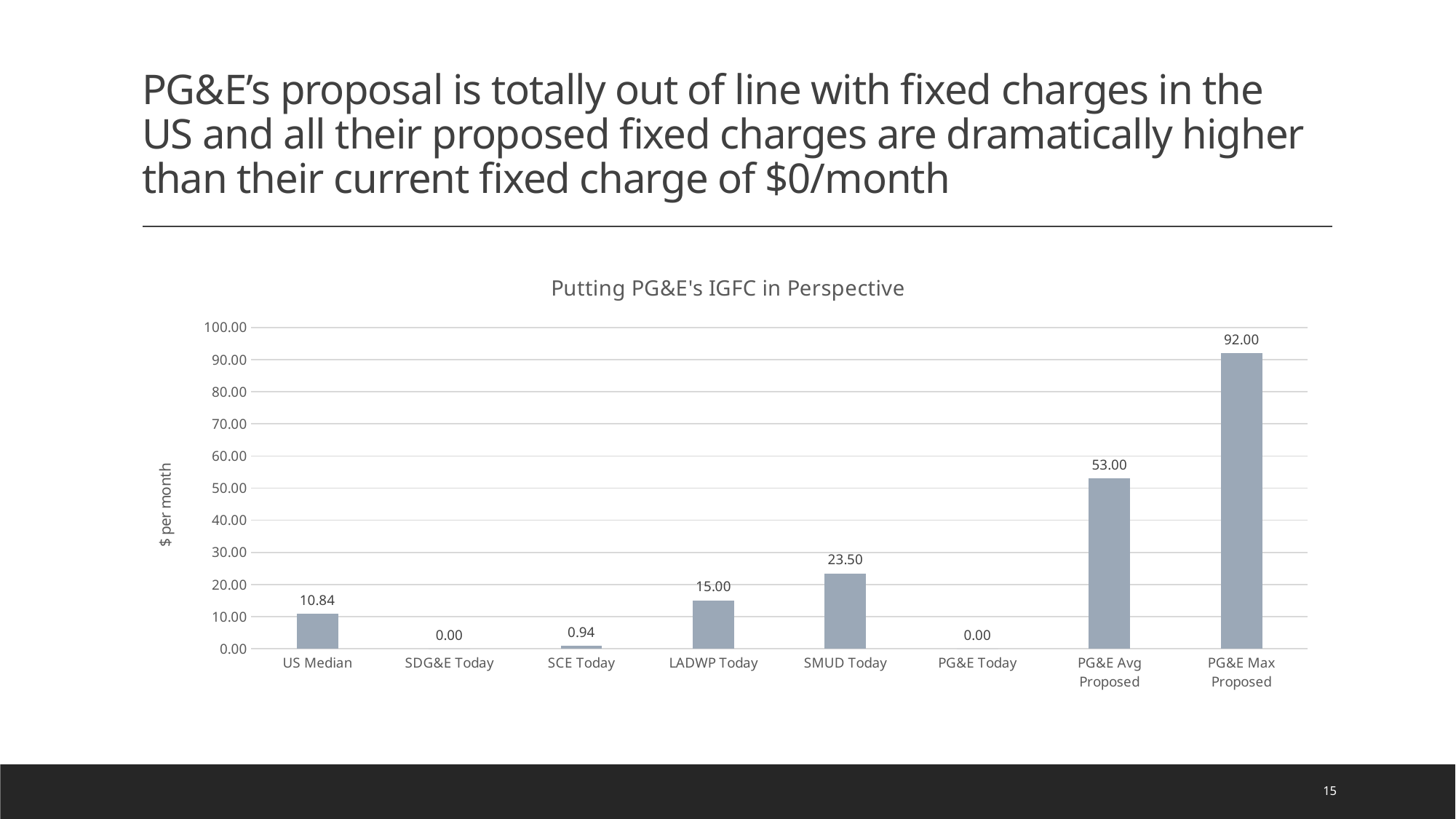
Which is larger, LADWP Today or US Median? LADWP Today What is the difference between SMUD Today and LADWP Today? 8.50 Is the value for PG&E Max Proposed greater or less than 90.00? greater What kind of chart is shown? bar chart Which category has the highest value? PG&E Max Proposed What is the value for US Median? 10.84 What is the value for PG&E Avg Proposed? 53.00 What is the difference between PG&E Max Proposed and PG&E Avg Proposed? 39.00 What is the title of the chart? Putting PG&E's IGFC in Perspective How many categories are shown on the x axis? 8 What is the value for SMUD Today? 23.50 What is the label of the y axis? $ per month